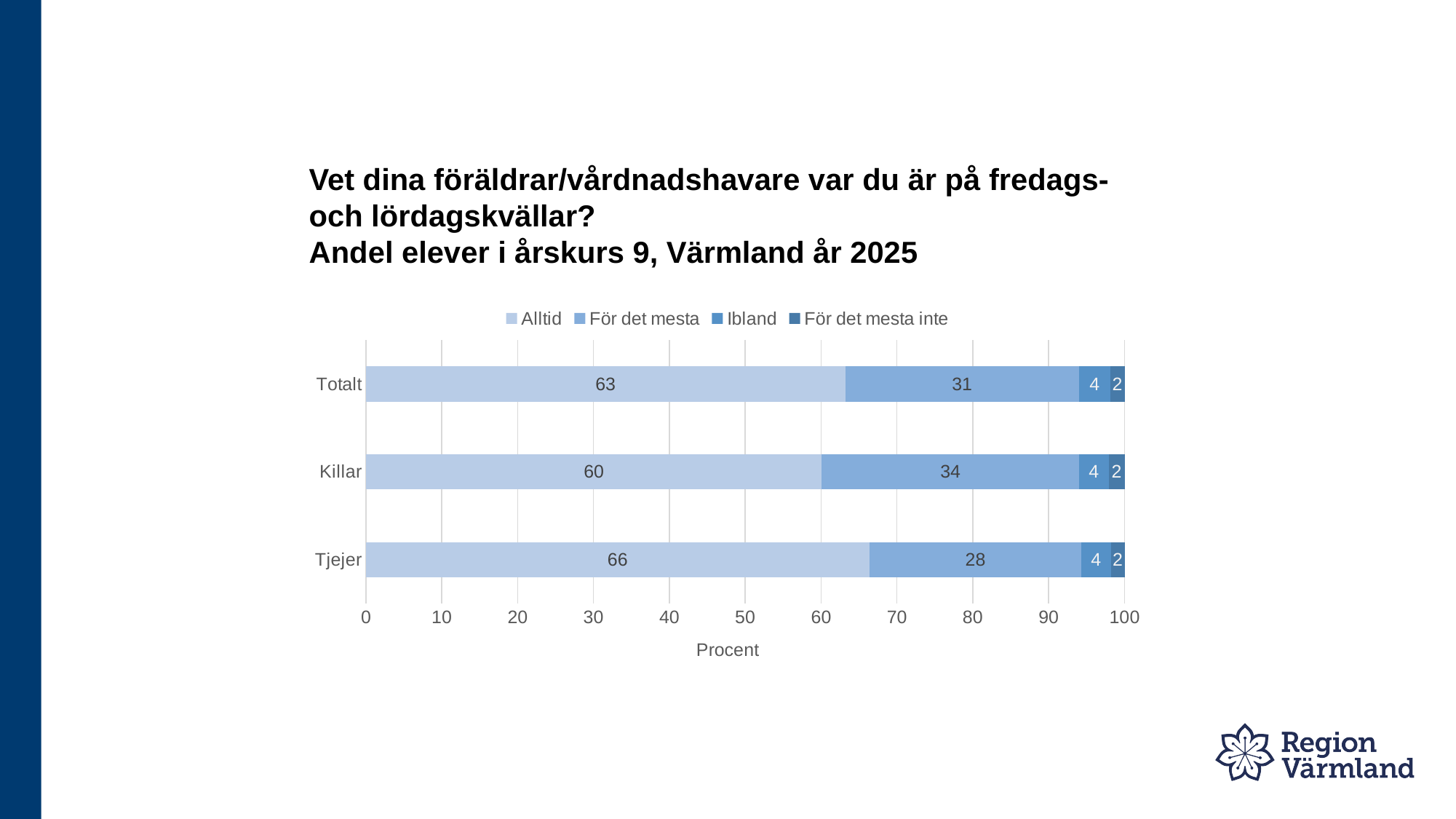
What is the label of the x axis? Procent What is the value for "För det mesta inte" for Tjejer? 2 What is the value for "Alltid" for Tjejer? 66 How many categories are shown on the y axis? 3 What is the value for "För det mesta" for Killar? 34 What kind of chart is shown on the slide? Stacked bar chart Which category has the highest value for "Alltid"? Tjejer Which category has the lowest value for "För det mesta"? Tjejer What is the value for "Ibland" for Totalt? 4 What is the difference between the "Alltid" values for Tjejer and Killar? 6 Which is larger: the "Alltid" value for Totalt or the "Alltid" value for Killar? Totalt How many series does the legend list? 4